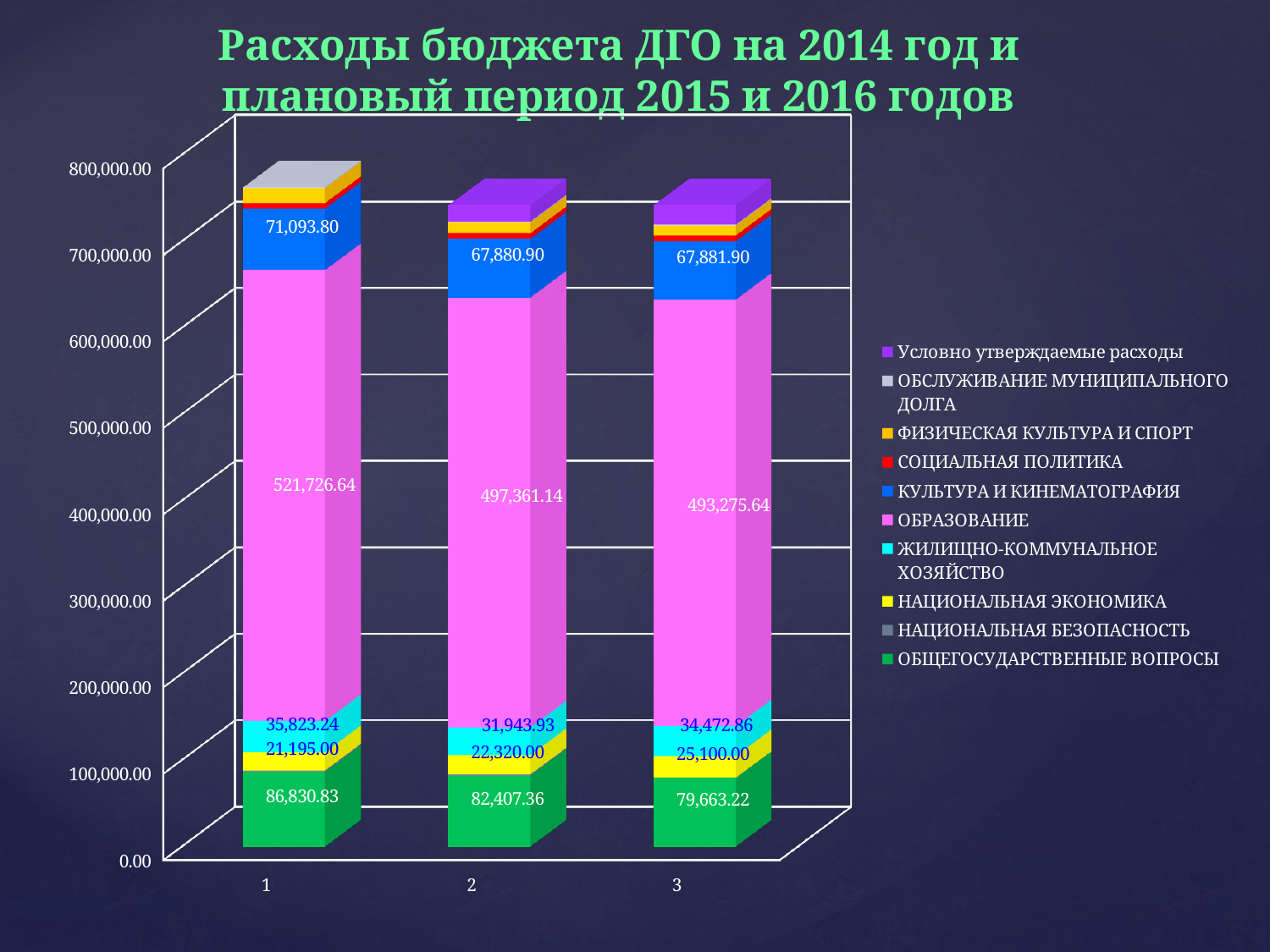
What is the value of КУЛЬТУРА И КИНЕМАТОГРАФИЯ for category 2? 67,880.90 What is the value of ОБРАЗОВАНИЕ for category 1? 521,726.64 Which is larger: ОБЩЕГОСУДАРСТВЕННЫЕ ВОПРОСЫ for category 1 or for category 2? category 1 What is the difference between the ОБРАЗОВАНИЕ values for category 1 and category 2? 24,365.50 What is the value of ОБЩЕГОСУДАРСТВЕННЫЕ ВОПРОСЫ for category 3? 79,663.22 Which category has the highest value for ОБРАЗОВАНИЕ? 1 What is the value of НАЦИОНАЛЬНАЯ ЭКОНОМИКА for category 3? 25,100.00 How many series does the legend list? 10 Which category has the lowest value for ЖИЛИЩНО-КОММУНАЛЬНОЕ ХОЗЯЙСТВО? 2 How many categories are shown on the x axis? 3 What kind of chart is shown on the slide? stacked bar chart Does the value of ОБЩЕГОСУДАРСТВЕННЫЕ ВОПРОСЫ fall along the x axis from category 1 to category 3? yes, it falls